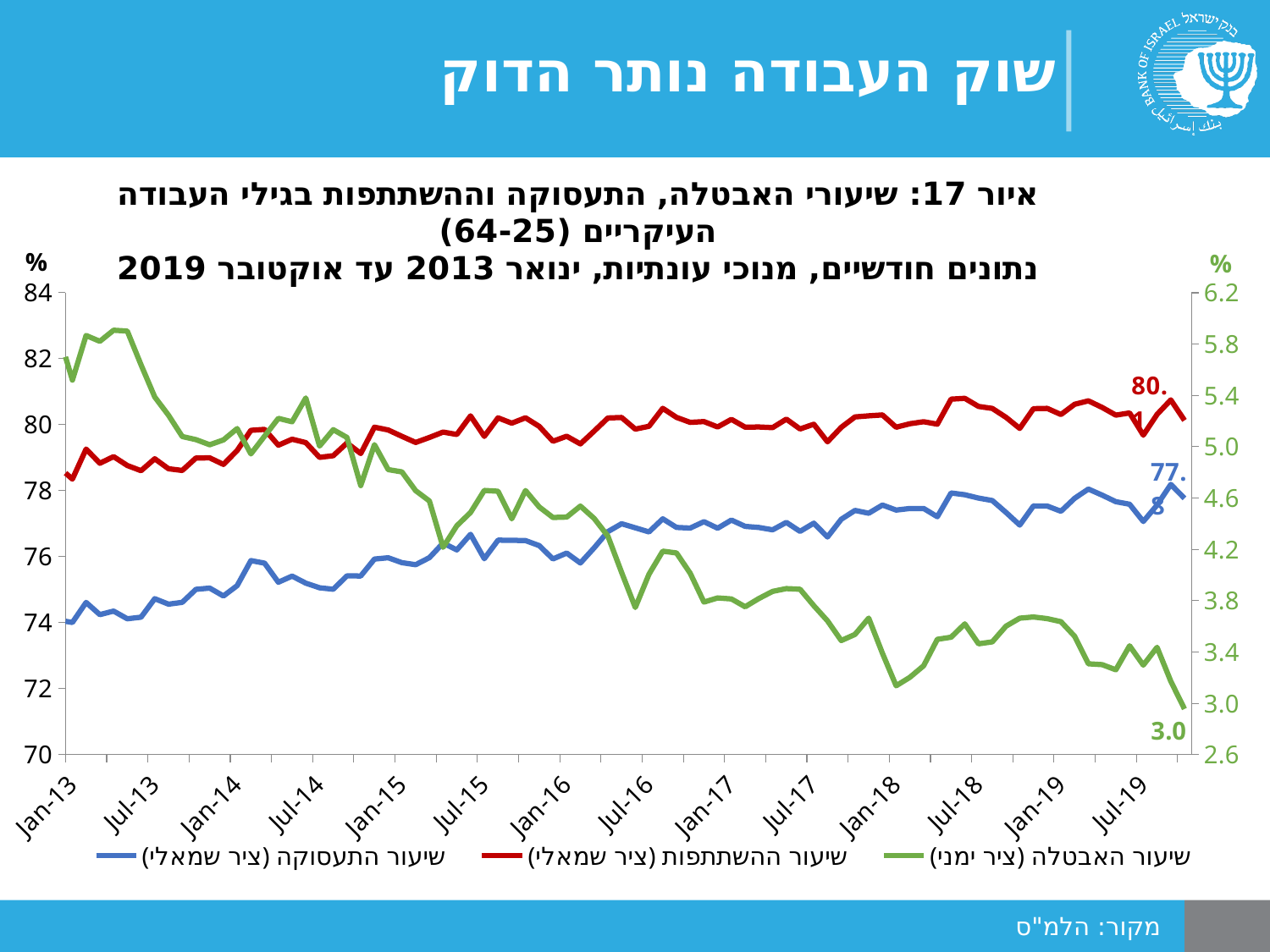
What kind of chart is shown on the slide? line chart Is the participation rate at Jan-13 greater or less than 80 on the left axis? less Does the unemployment rate (green line) rise or fall overall from Jan-13 to the end of the period? fall Which series is plotted on the right axis (ציר ימני) according to the legend? שיעור האבטלה (unemployment rate) What is the highest tick value shown on the right-hand axis? 6.2 Is the unemployment rate at Jan-13 greater or less than 5.0 on the right axis? greater What is the last data label shown on the unemployment rate (שיעור האבטלה) line? 3.0 Does the employment rate (blue line) rise or fall overall from Jan-13 to the end of the period? rise At Jan-13, which is higher on the left axis: the participation rate (red line) or the employment rate (blue line)? participation rate (red line) Is the employment rate at Jan-13 greater or less than 76 on the left axis? less How many series does the legend list? 3